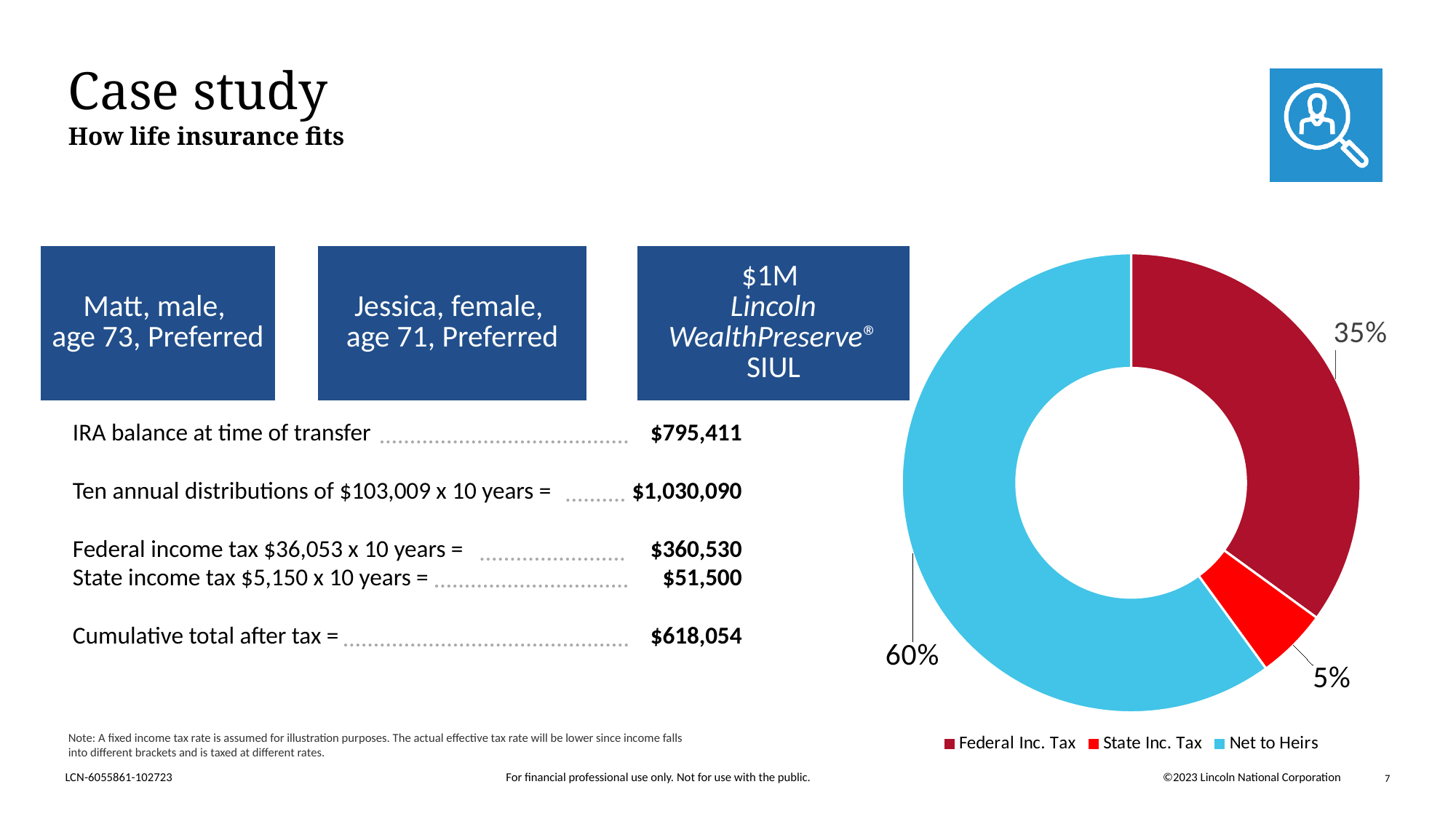
What kind of chart is shown on the slide? Donut (pie) chart What is the difference in percentage points between the Federal Inc. Tax share and the State Inc. Tax share? 30 How many categories does the donut chart show? 3 Which category has the largest share in the donut chart? Net to Heirs Which is larger in the donut chart, Federal Inc. Tax or State Inc. Tax? Federal Inc. Tax What colour is the Net to Heirs slice in the donut chart? Light blue Which category has the smallest share in the donut chart? State Inc. Tax What share of the donut chart is State Inc. Tax? 5% What is the combined share of Federal Inc. Tax and State Inc. Tax in the donut chart? 40% What is the difference in percentage points between the Net to Heirs share and the Federal Inc. Tax share? 25 What share of the donut chart is Federal Inc. Tax? 35% What share of the donut chart is Net to Heirs? 60%